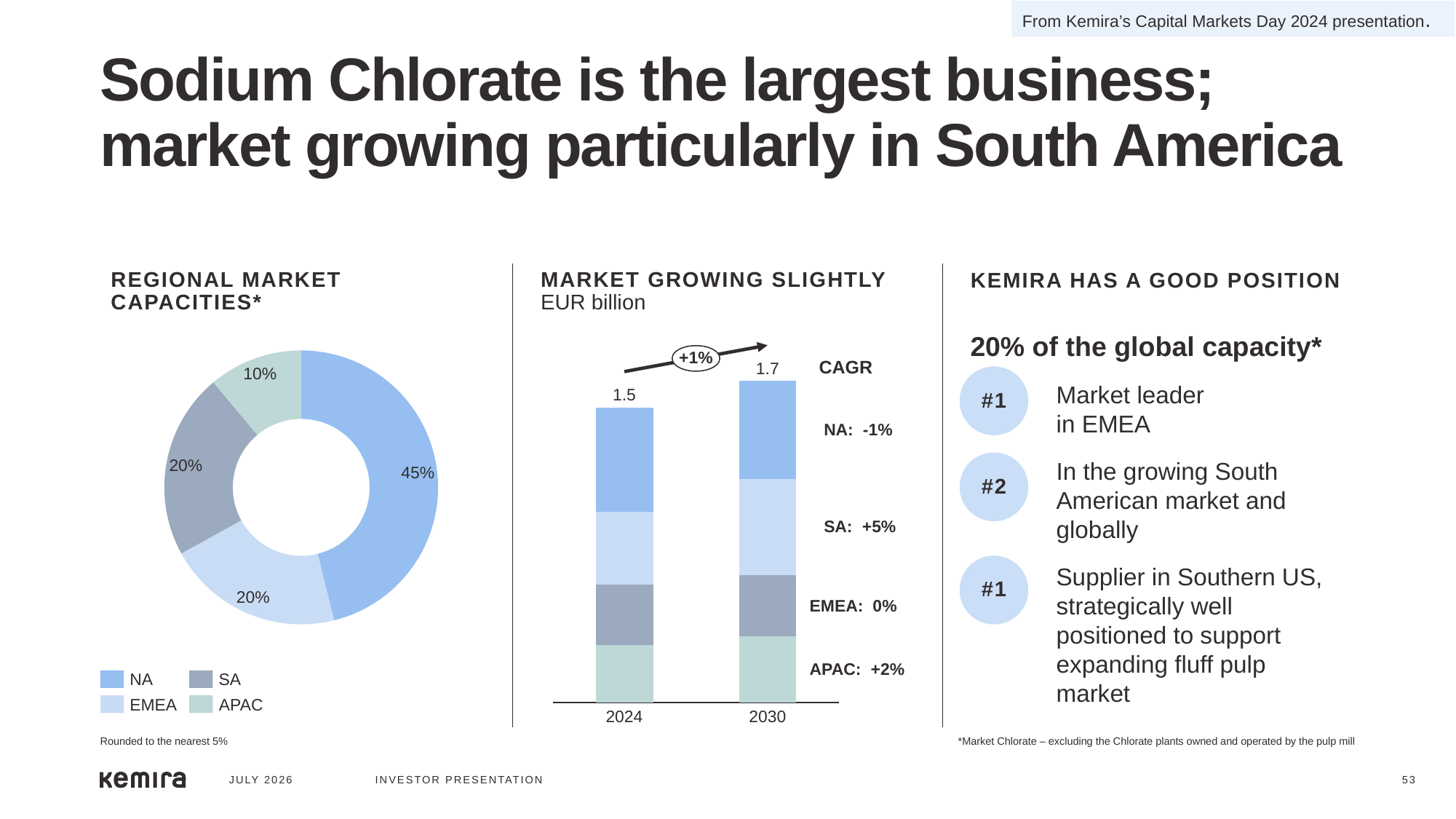
In the Regional Market Capacities chart, what is the difference in percentage points between the NA share and the SA share? 25 percentage points In the Market Growing Slightly chart, what is the total market value for 2030? 1.7 What kind of chart is the Market Growing Slightly chart? Stacked bar chart In the Regional Market Capacities chart, which region has the smallest share? APAC In the Regional Market Capacities chart, which region has the largest share? NA In the Market Growing Slightly chart, what is the total market value for 2024? 1.5 In the Market Growing Slightly chart, what CAGR is shown for SA? +5% In the Regional Market Capacities chart, how many regions are shown in the legend? 4 What kind of chart is the Regional Market Capacities chart? Donut (pie) chart In the Regional Market Capacities chart, what share of capacity does APAC hold? 10% In the Market Growing Slightly chart, what is the difference between the 2030 and 2024 totals? 0.2 In the Regional Market Capacities chart, what share of capacity does NA hold? 45%